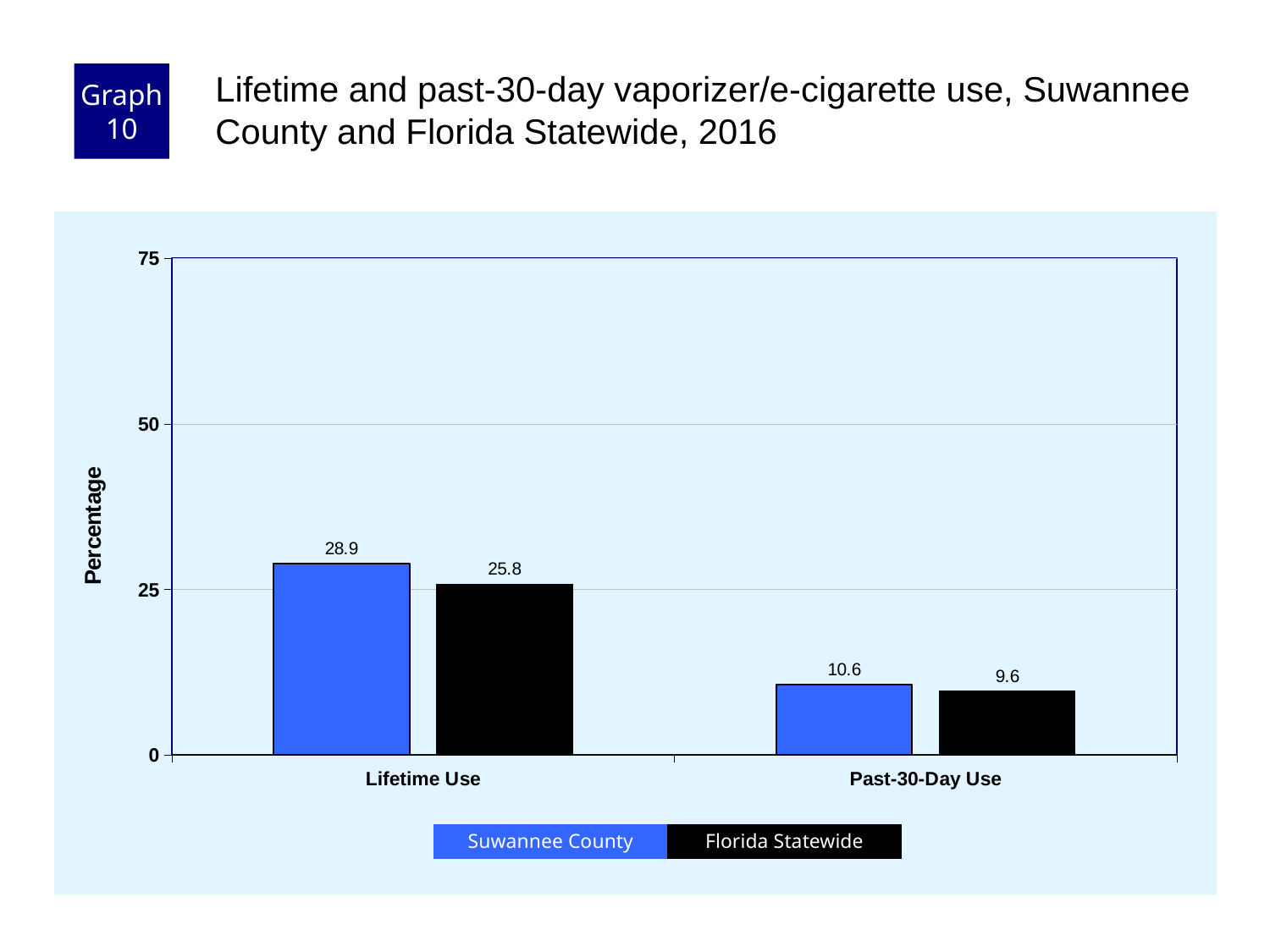
What kind of chart is shown on the slide? Bar chart What is the Florida Statewide value for Lifetime Use? 25.8 How many categories are shown on the x axis? 2 What is the Suwannee County value for Lifetime Use? 28.9 How many series does the legend list? 2 Which bar has the highest value on the chart? Suwannee County, Lifetime Use For Past-30-Day Use, which is larger: Suwannee County or Florida Statewide? Suwannee County What is the difference between the Suwannee County and Florida Statewide values for Past-30-Day Use? 1.0 What is the difference between the Suwannee County and Florida Statewide values for Lifetime Use? 3.1 What is the Suwannee County value for Past-30-Day Use? 10.6 Which bar has the lowest value on the chart? Florida Statewide, Past-30-Day Use What is the Florida Statewide value for Past-30-Day Use? 9.6